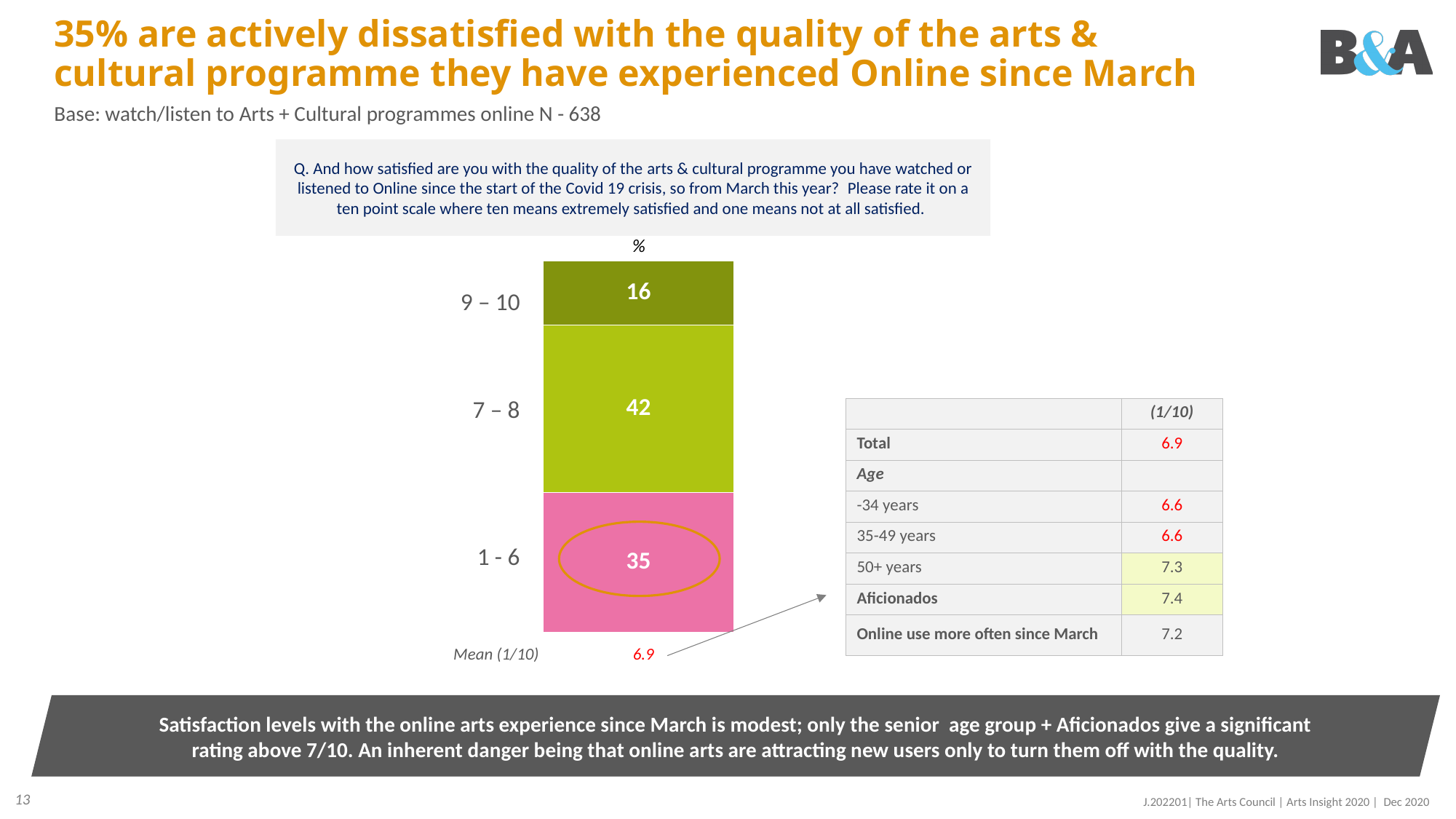
Which rating band has the smallest share of respondents? 9 – 10 What percentage of respondents gave a rating of 9 – 10? 16 What is the difference in percentage points between the 7 – 8 band and the 1 - 6 band? 7 Which is larger, the share rating 1 - 6 or the share rating 9 – 10? 1 - 6 What percentage of respondents gave a rating of 7 – 8? 42 What percentage of respondents gave a rating of 1 - 6? 35 What is the difference in percentage points between the 7 – 8 band and the 9 – 10 band? 26 What is the total of the three segments in the stacked bar? 93 Which rating band has the largest share of respondents? 7 – 8 How many rating bands are shown in the stacked bar? 3 What kind of chart is shown on the slide? Stacked bar chart What mean score (1/10) is shown beneath the stacked bar? 6.9